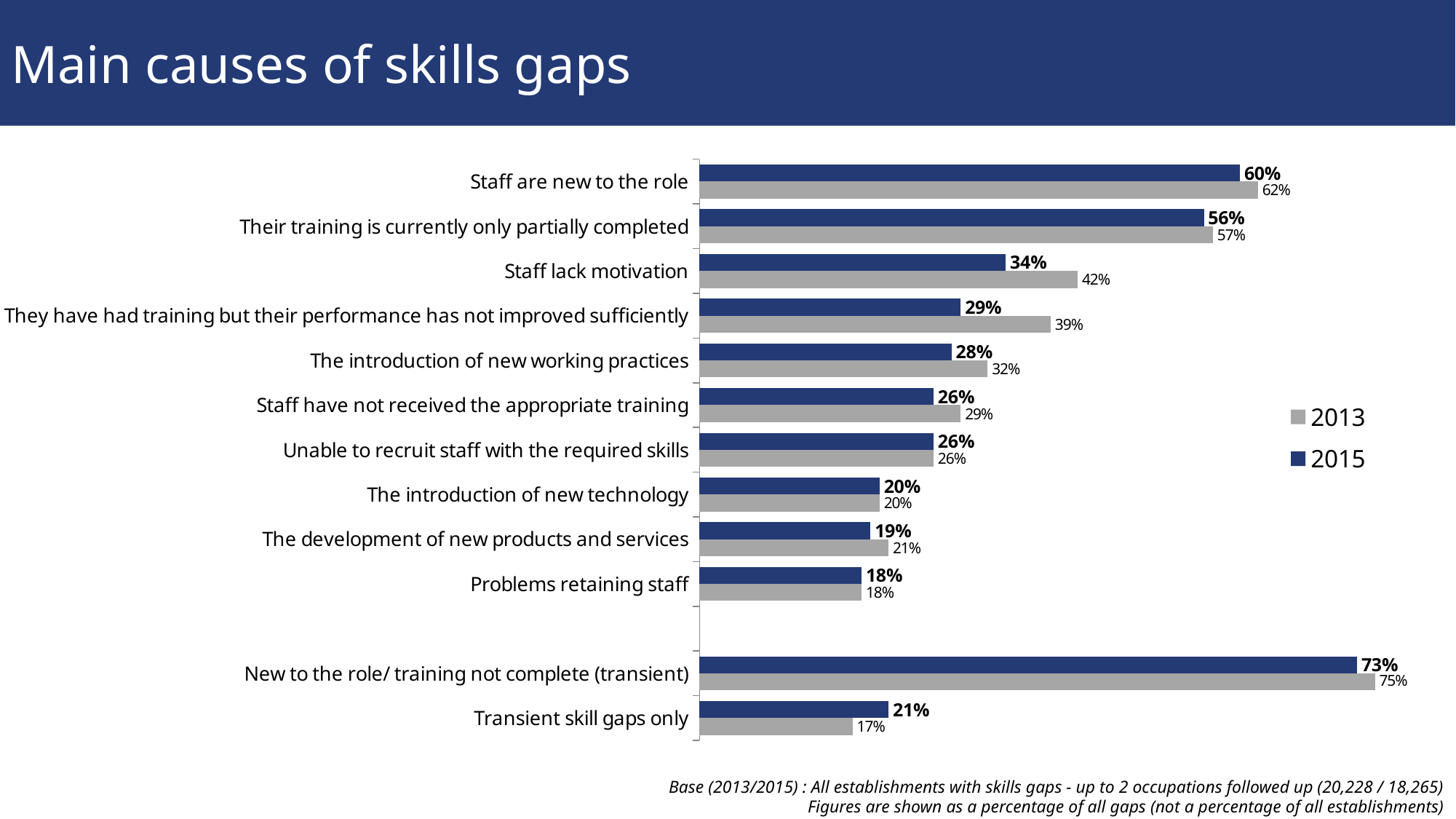
How many series does the legend list? 2 Which category has the highest 2015 value? New to the role/ training not complete (transient) For "Transient skill gaps only", which year has the larger value, 2013 or 2015? 2015 Which category has the lowest 2013 value? Transient skill gaps only What is the 2013 value for "They have had training but their performance has not improved sufficiently"? 39% What is the difference between the 2013 and 2015 values for "Staff lack motivation"? 8 percentage points Which colour represents 2015 in the chart? Dark blue What kind of chart is shown on the slide? Bar chart What is the 2013 value for "Transient skill gaps only"? 17% What is the difference between the 2013 and 2015 values for "Staff are new to the role"? 2 percentage points For "The introduction of new working practices", which year has the larger value, 2013 or 2015? 2013 What is the 2015 value for "Staff lack motivation"? 34%